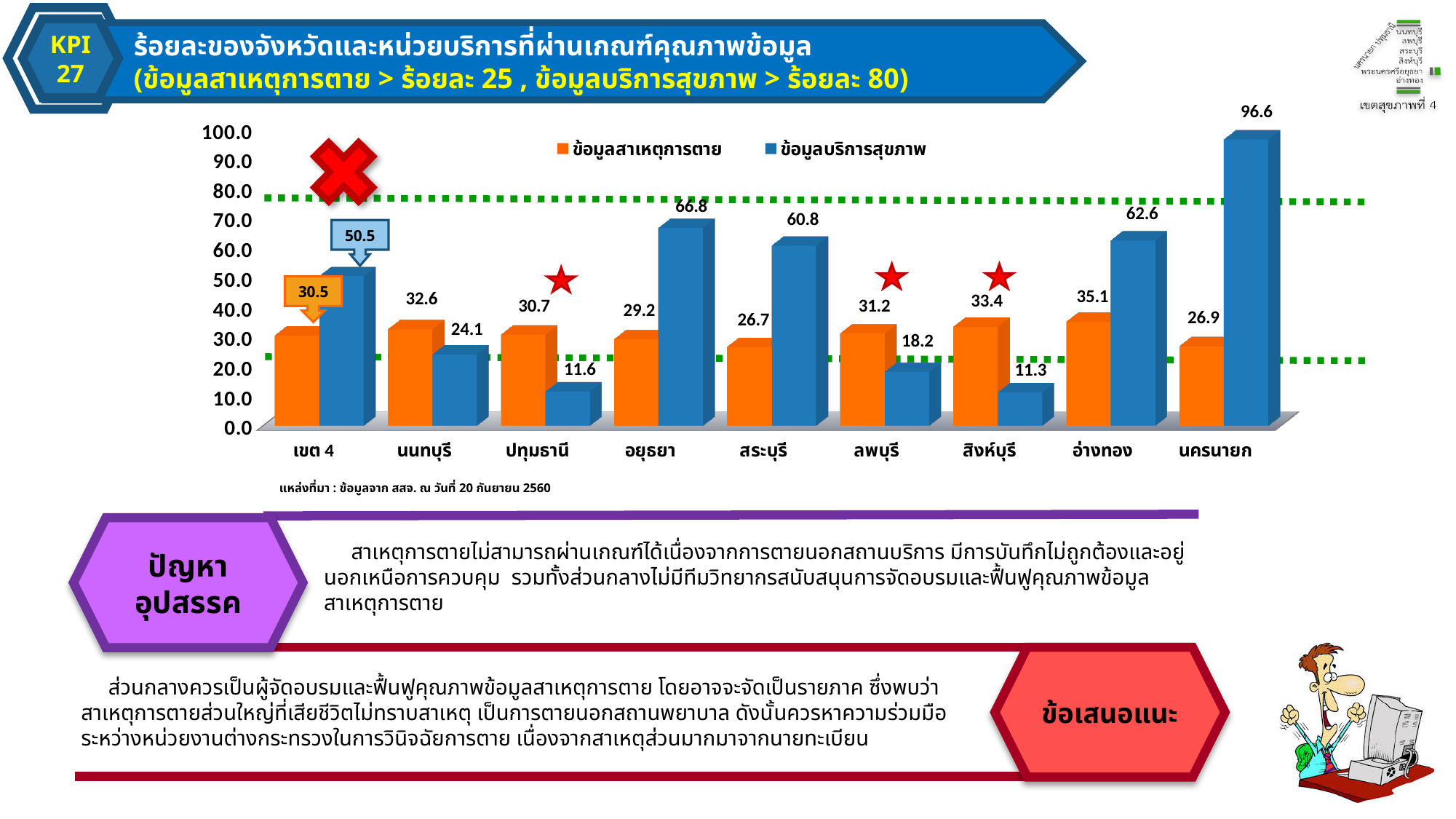
Which category has the highest value for ข้อมูลบริการสุขภาพ? นครนายก Which category has the lowest value for ข้อมูลสาเหตุการตาย? สระบุรี Is the ข้อมูลบริการสุขภาพ value for อยุธยา greater or less than 60.0? greater What is the value of ข้อมูลบริการสุขภาพ for นครนายก? 96.6 Which is larger for ปทุมธานี: ข้อมูลสาเหตุการตาย or ข้อมูลบริการสุขภาพ? ข้อมูลสาเหตุการตาย What is the value of ข้อมูลสาเหตุการตาย for อ่างทอง? 35.1 How many categories are shown on the x axis of the chart? 9 How many series does the chart legend list? 2 What is the difference between the ข้อมูลบริการสุขภาพ value and the ข้อมูลสาเหตุการตาย value for เขต 4? 20.0 Which colour represents ข้อมูลบริการสุขภาพ in the chart? blue What kind of chart is shown on the slide? bar chart What is the value of ข้อมูลบริการสุขภาพ for สิงห์บุรี? 11.3